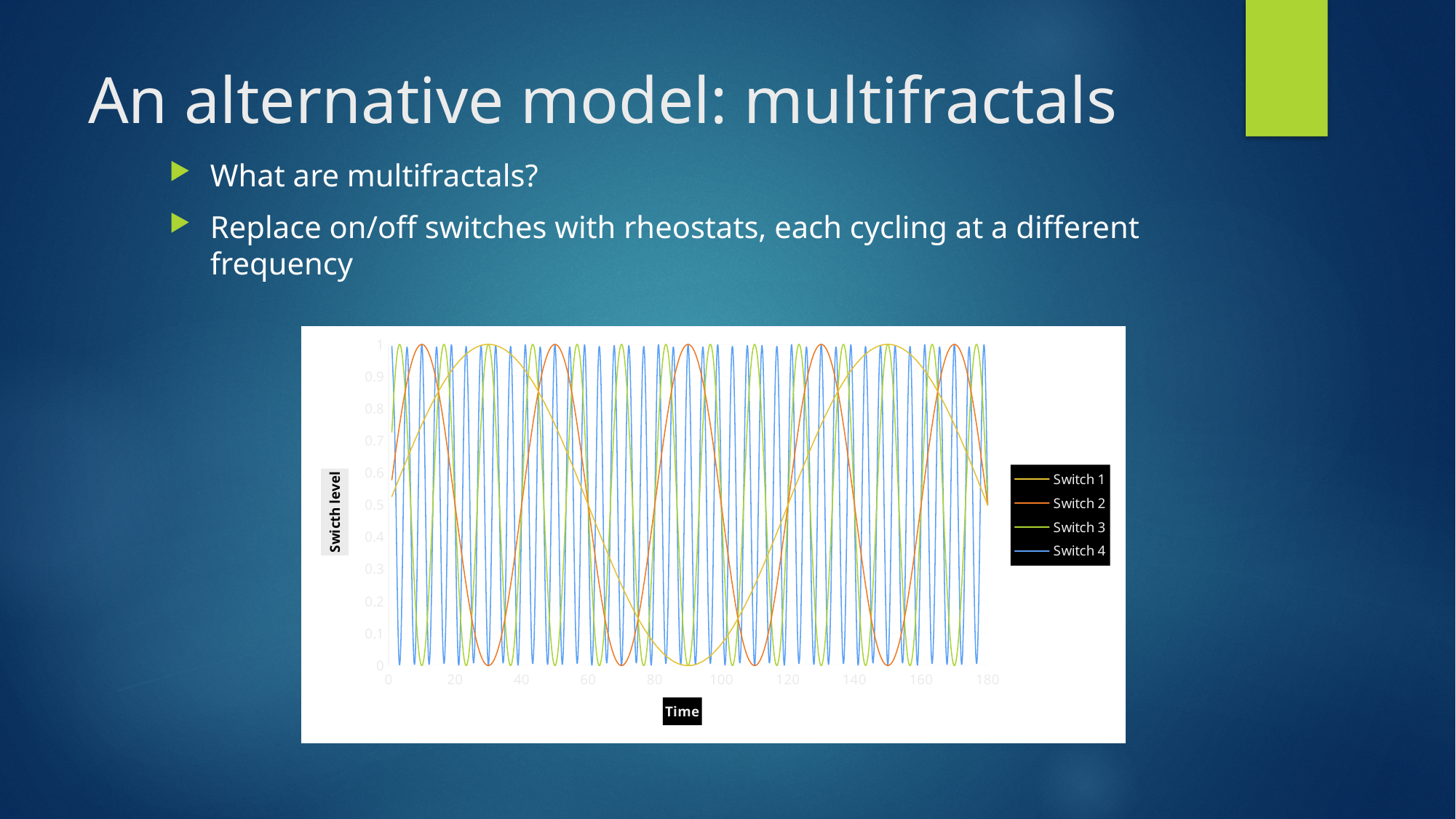
What are the series names listed in the legend? Switch 1, Switch 2, Switch 3, Switch 4 Is the value for Switch 2 at time 10 greater or less than 0.5? greater Does the Switch 1 line rise or fall between time 0 and time 30? rise Is the value for Switch 1 at time 90 greater or less than 0.5? less What kind of chart is shown on the slide? line chart How many series does the legend list? 4 What is the title of the x axis? Time At time 90, which is higher, Switch 1 or Switch 2? Switch 2 Is the value for Switch 1 at time 30 greater or less than 0.5? greater At time 30, which is higher, Switch 1 or Switch 2? Switch 1 Does the Switch 1 line rise or fall between time 30 and time 90? fall